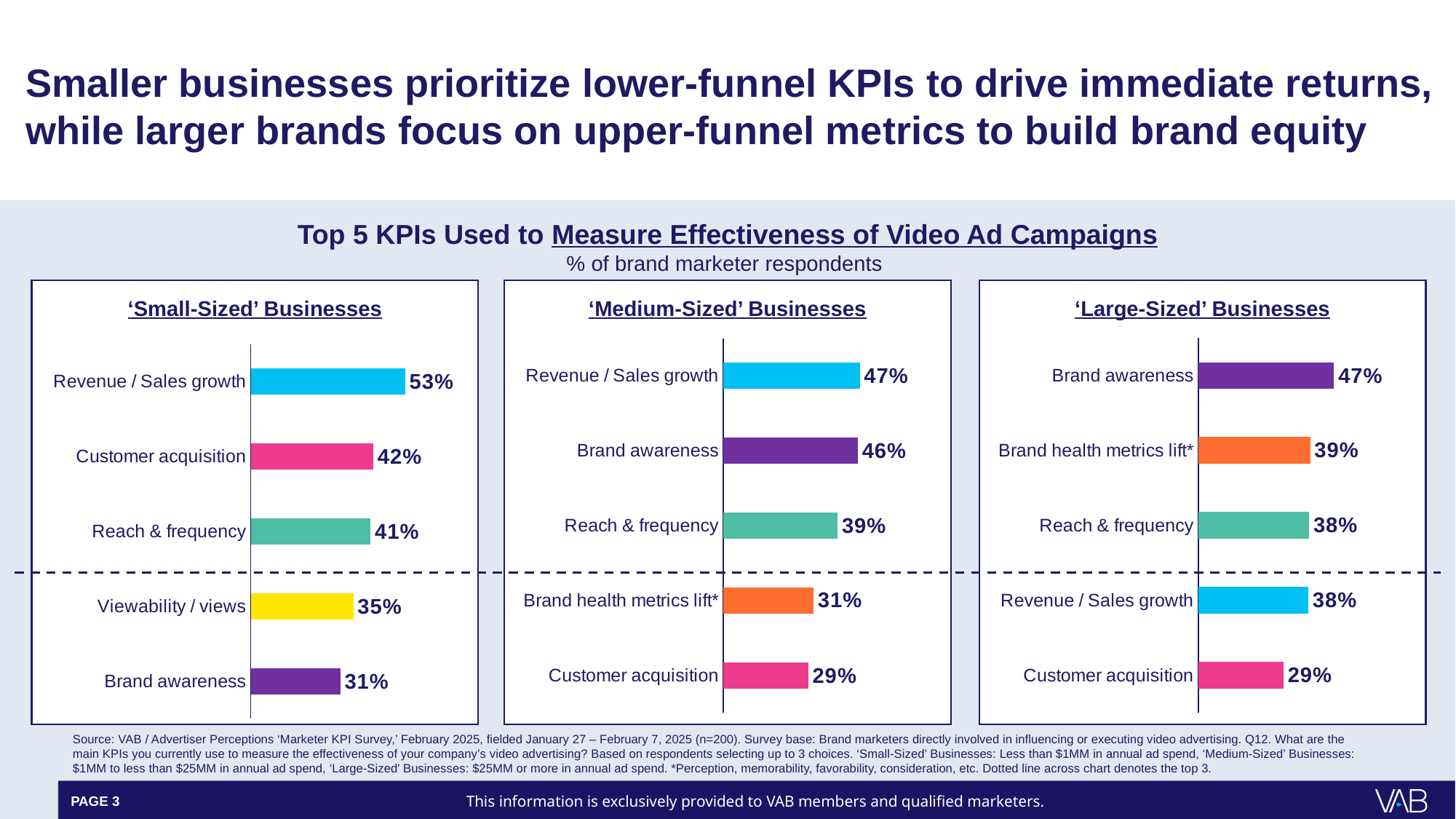
In the 'Small-Sized' Businesses chart, what is the difference between Revenue / Sales growth and Brand awareness? 22 percentage points In the 'Small-Sized' Businesses chart, what percentage of respondents selected Revenue / Sales growth? 53% What type of chart is used for the 'Small-Sized' Businesses panel? Bar chart How many KPIs are shown in the 'Medium-Sized' Businesses chart? 5 In the 'Medium-Sized' Businesses chart, which KPI has the lowest value? Customer acquisition In the 'Large-Sized' Businesses chart, which is larger: Brand awareness or Customer acquisition? Brand awareness What does the dotted line across the charts denote? The top 3 In the 'Small-Sized' Businesses chart, which KPI has the lowest value? Brand awareness In the 'Medium-Sized' Businesses chart, what is the value for Brand awareness? 46% In the 'Medium-Sized' Businesses chart, what is the difference between Reach & frequency and Brand health metrics lift*? 8 percentage points In the 'Large-Sized' Businesses chart, which KPI has the highest value? Brand awareness In the 'Large-Sized' Businesses chart, what is the value for Brand health metrics lift*? 39%